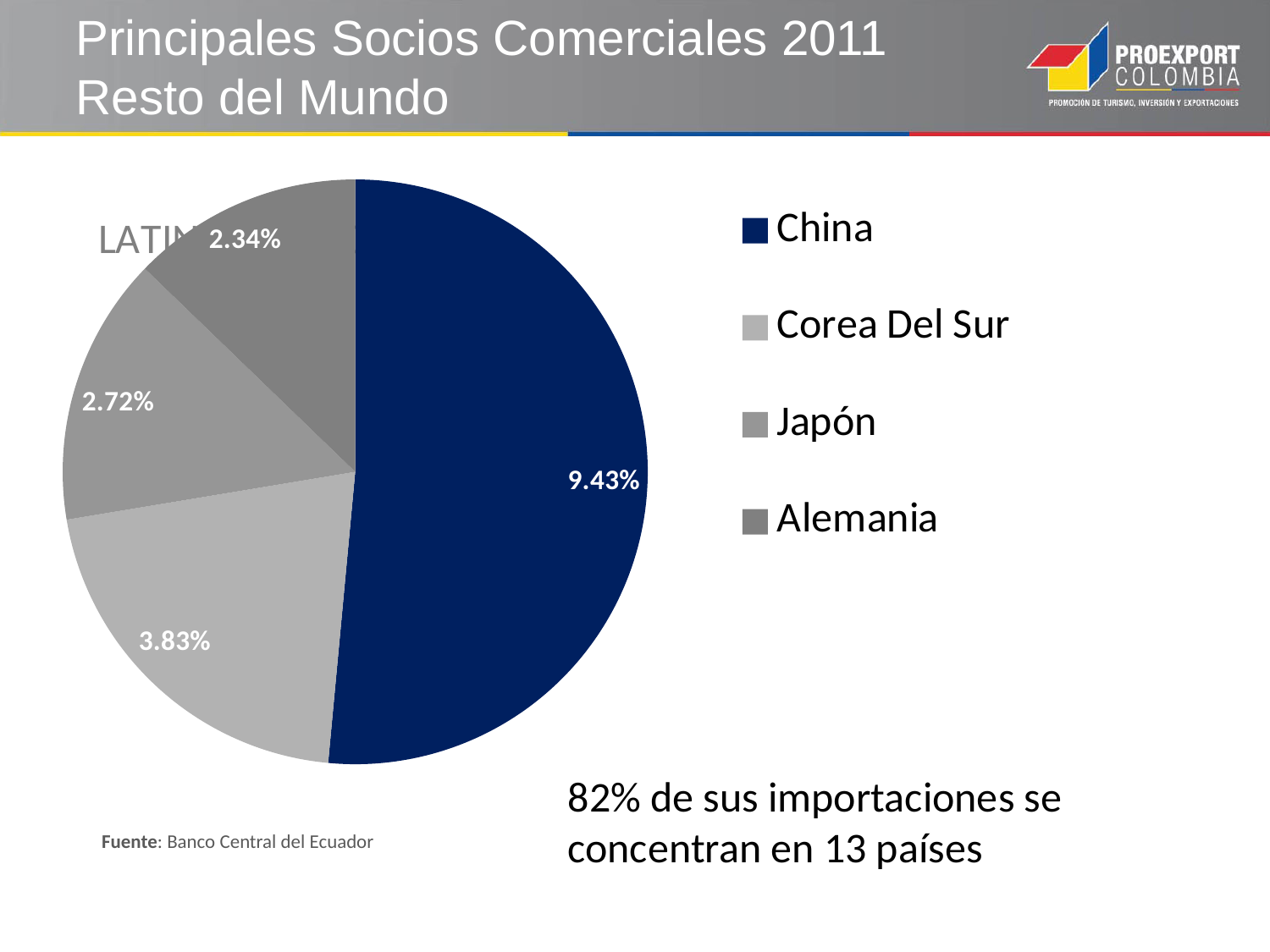
What kind of chart is shown on the slide? pie chart What value is shown for Japón in the pie chart? 2.72% How many countries are shown in the pie chart? 4 Which is larger, the value for Corea Del Sur or the value for Japón? Corea Del Sur What colour is the slice for China in the pie chart? dark blue What is the difference between the values for China and Corea Del Sur? 5.60% Which country has the largest slice in the pie chart? China Which country has the smallest slice in the pie chart? Alemania What value is shown for Corea Del Sur in the pie chart? 3.83% What is the difference between the values for Japón and Alemania? 0.38% What value is shown for China in the pie chart? 9.43% What value is shown for Alemania in the pie chart? 2.34%